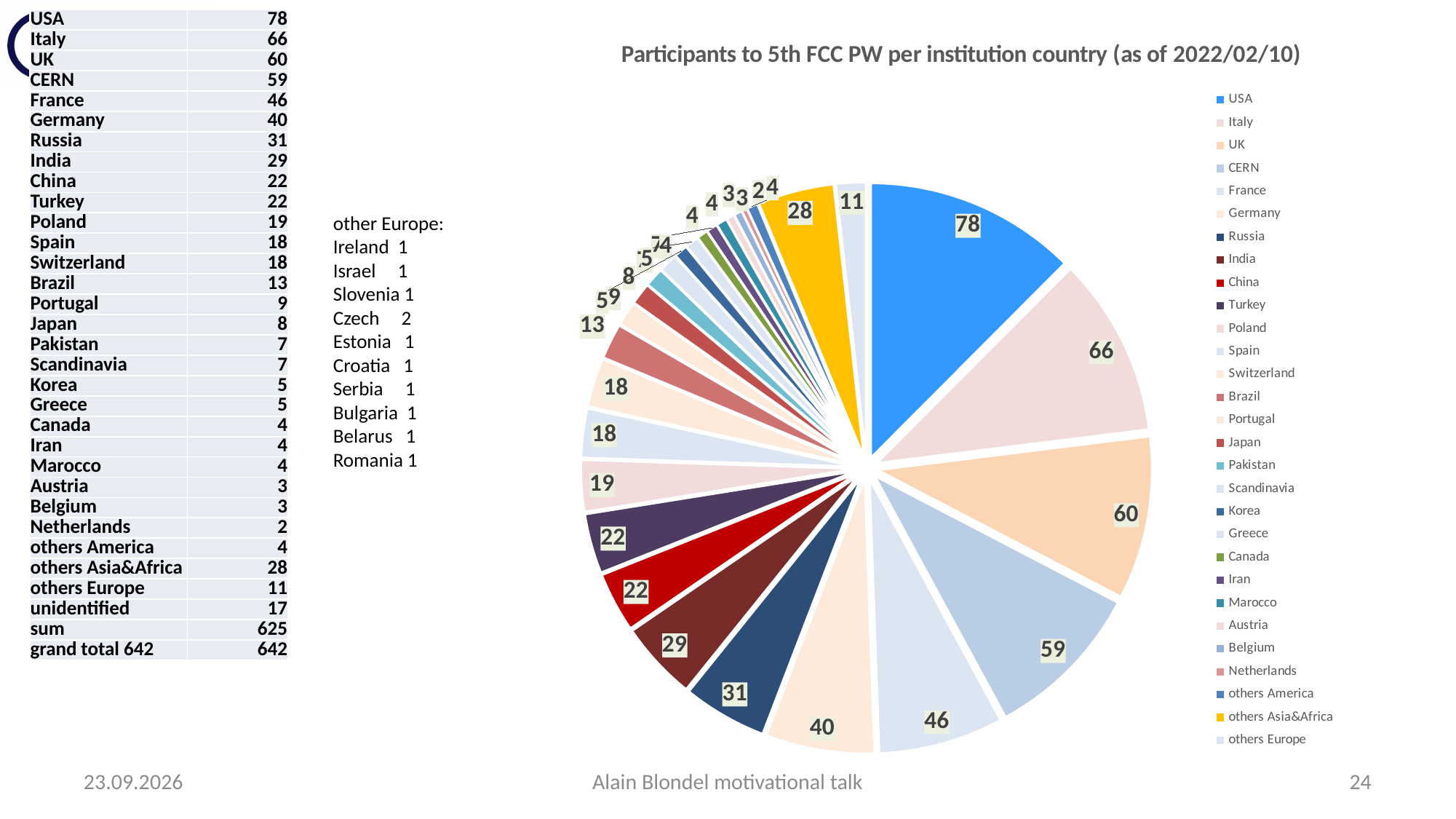
Which country has the largest slice of the pie? USA How many participants does the chart show for Italy? 66 Which has the larger value in the chart, India or Russia? Russia What value is shown for others Asia&Africa in the chart? 28 What is the difference between the France and Germany values in the chart? 6 Which has the larger value in the chart, UK or CERN? UK What value is shown for Russia in the chart? 31 What is the difference between the USA and Italy values in the chart? 12 What kind of chart is shown on the slide? pie chart What is the title of the chart? Participants to 5th FCC PW per institution country (as of 2022/02/10) How many categories does the chart's legend list? 29 How many participants does the chart show for USA? 78